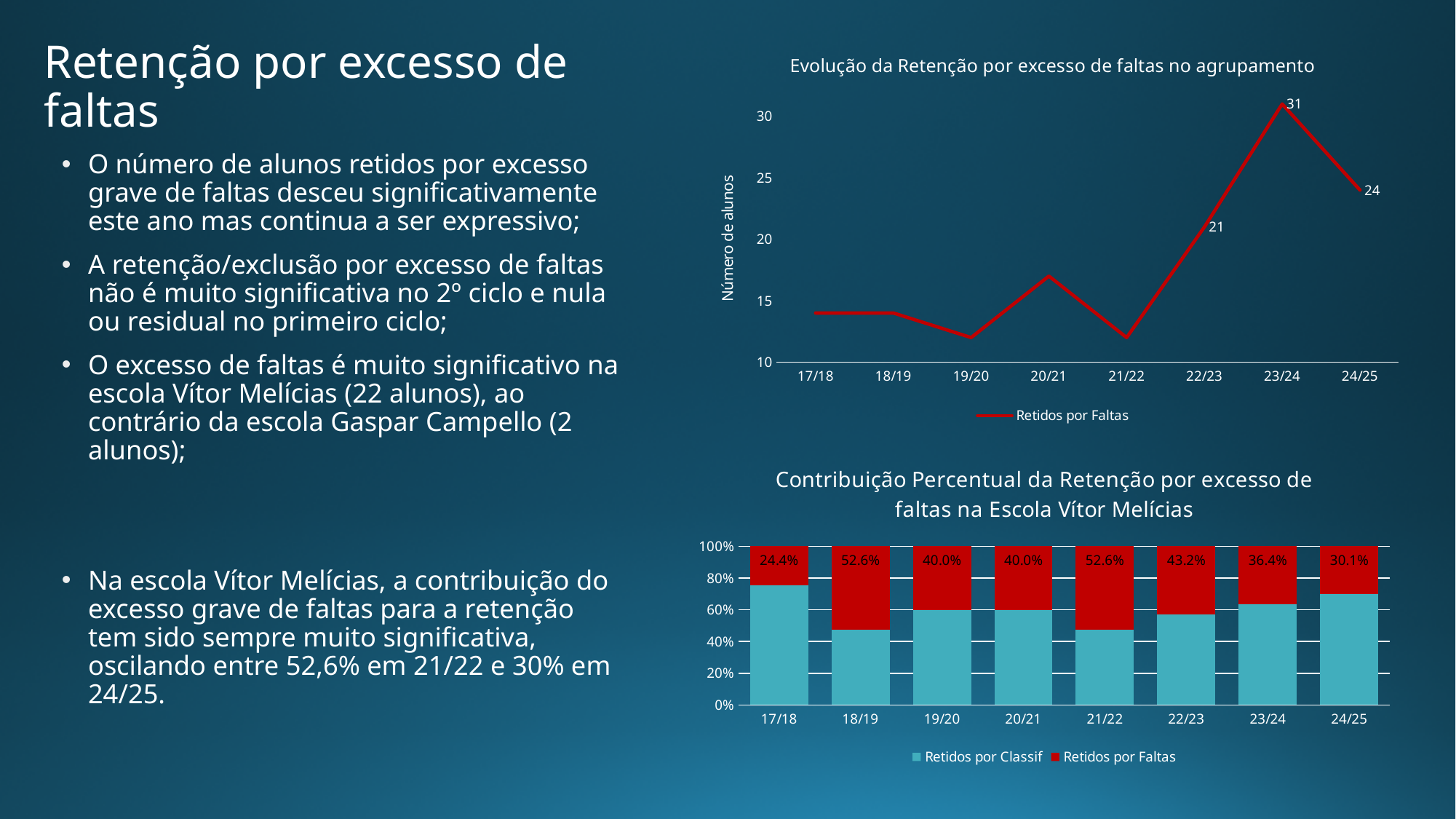
In the chart 'Evolução da Retenção por excesso de faltas no agrupamento', what is the value for 24/25? 24 In the chart 'Evolução da Retenção por excesso de faltas no agrupamento', is the value for 21/22 greater or less than 15? less In the chart 'Evolução da Retenção por excesso de faltas no agrupamento', is the value for 20/21 greater or less than 15? greater How many series does the legend of the chart 'Contribuição Percentual da Retenção por excesso de faltas na Escola Vítor Melícias' list? 2 In the chart 'Evolução da Retenção por excesso de faltas no agrupamento', what is the value for 23/24? 31 In the chart 'Evolução da Retenção por excesso de faltas no agrupamento', which year has the highest value? 23/24 In the chart 'Evolução da Retenção por excesso de faltas no agrupamento', what is the difference between the values for 23/24 and 22/23? 10 In the chart 'Evolução da Retenção por excesso de faltas no agrupamento', how many school years are shown on the x axis? 8 In the chart 'Contribuição Percentual da Retenção por excesso de faltas na Escola Vítor Melícias', is the Retidos por Faltas value larger for 22/23 or for 23/24? 22/23 In the chart 'Contribuição Percentual da Retenção por excesso de faltas na Escola Vítor Melícias', what is the Retidos por Faltas value for 24/25? 30.1% What kind of chart is 'Evolução da Retenção por excesso de faltas no agrupamento'? Line chart In the chart 'Contribuição Percentual da Retenção por excesso de faltas na Escola Vítor Melícias', which year has the lowest Retidos por Faltas value? 17/18